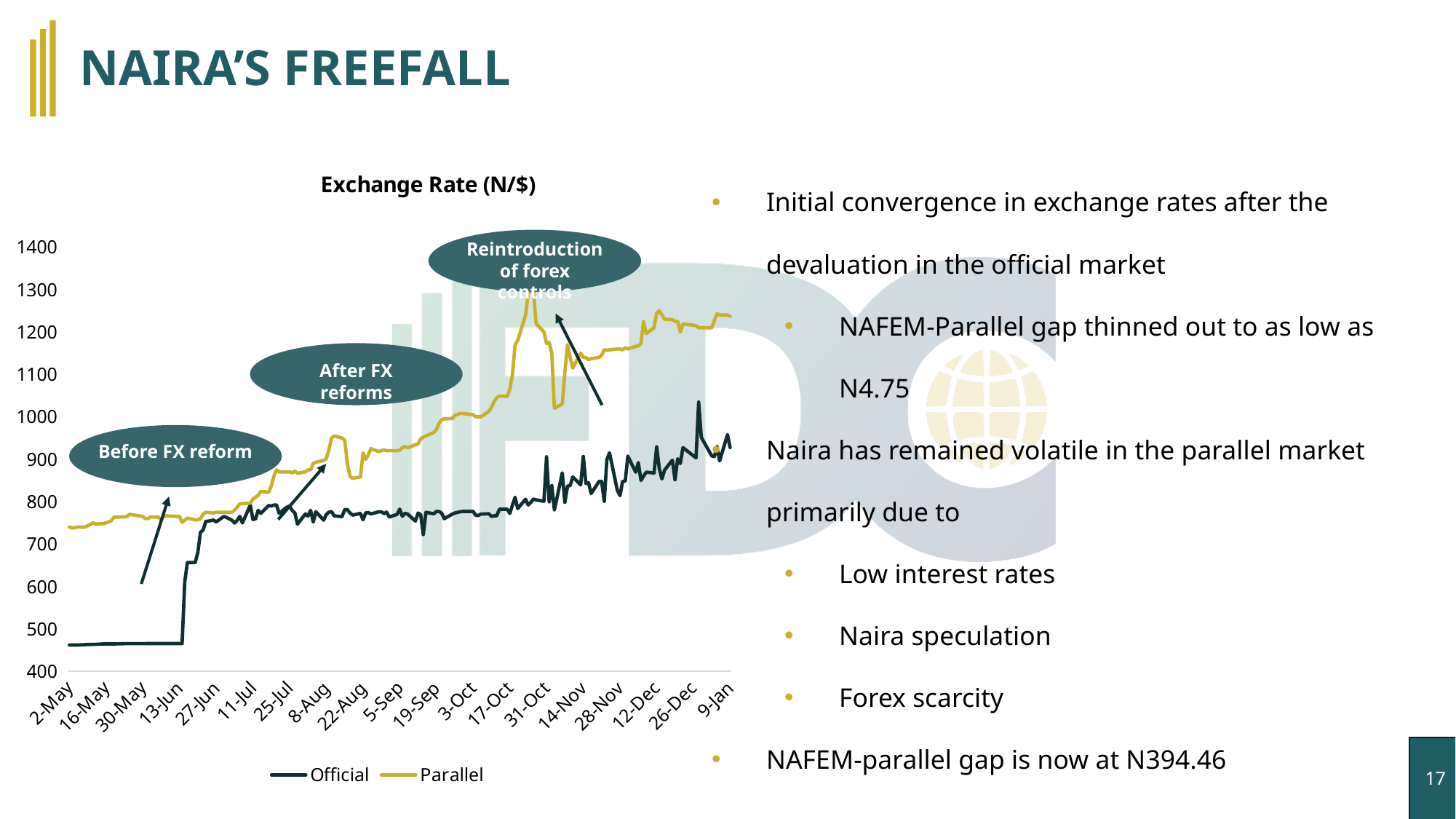
What are the two series named in the legend of the Exchange Rate chart? Official and Parallel Is the Parallel exchange rate at 9-Jan greater or less than 1200? greater What is the title of the chart on the slide? Exchange Rate (N/$) How many series does the legend of the Exchange Rate chart list? 2 What kind of chart is shown on the slide? line chart Does the Parallel exchange rate generally rise or fall from 2-May to 9-Jan? rise What is the highest value shown on the vertical axis of the Exchange Rate chart? 1400 Is the Parallel exchange rate at 2-May greater or less than 700? greater Does the Official exchange rate generally rise or fall from 2-May to 9-Jan? rise Is the Official exchange rate at 9-Jan greater or less than 800? greater At 9-Jan, which series shows the higher exchange rate, Official or Parallel? Parallel